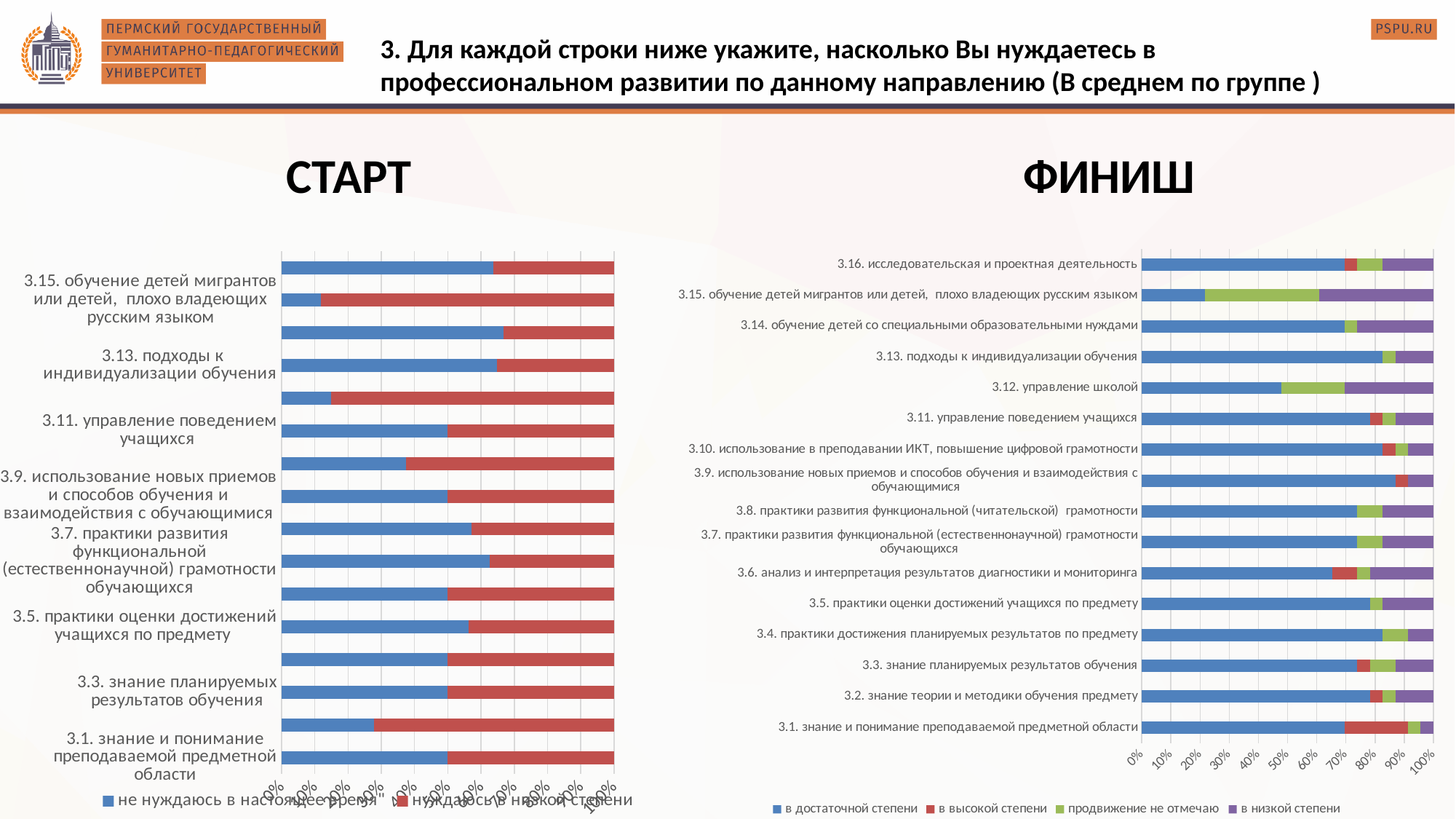
In the ФИНИШ chart, which category has the largest 'продвижение не отмечаю' (green) segment? 3.15. обучение детей мигрантов или детей, плохо владеющих русским языком What kind of chart is the СТАРТ chart on the left? Stacked bar chart How many series does the legend of the СТАРТ chart on the left list? 2 In the СТАРТ chart, is the 'не нуждаюсь в настоящее время' value for 3.11 greater or less than 20%? greater How many series does the legend of the ФИНИШ chart on the right list? 4 In the ФИНИШ chart, which category has the largest 'в высокой степени' (red) segment? 3.1. знание и понимание преподаваемой предметной области In the ФИНИШ chart, is the 'в достаточной степени' value for 3.15 greater or less than 30%? less In the ФИНИШ chart, is the 'в достаточной степени' value for 3.13 greater or less than 80%? greater In the СТАРТ chart, which has the larger 'не нуждаюсь в настоящее время' segment: 3.13 or 3.11? 3.13. подходы к индивидуализации обучения In the ФИНИШ chart, which category has the smallest 'в достаточной степени' (blue) segment? 3.15. обучение детей мигрантов или детей, плохо владеющих русским языком In the ФИНИШ chart, which has the larger 'в достаточной степени' segment: 3.12 or 3.15? 3.12. управление школой How many categories are plotted in the ФИНИШ chart on the right? 16